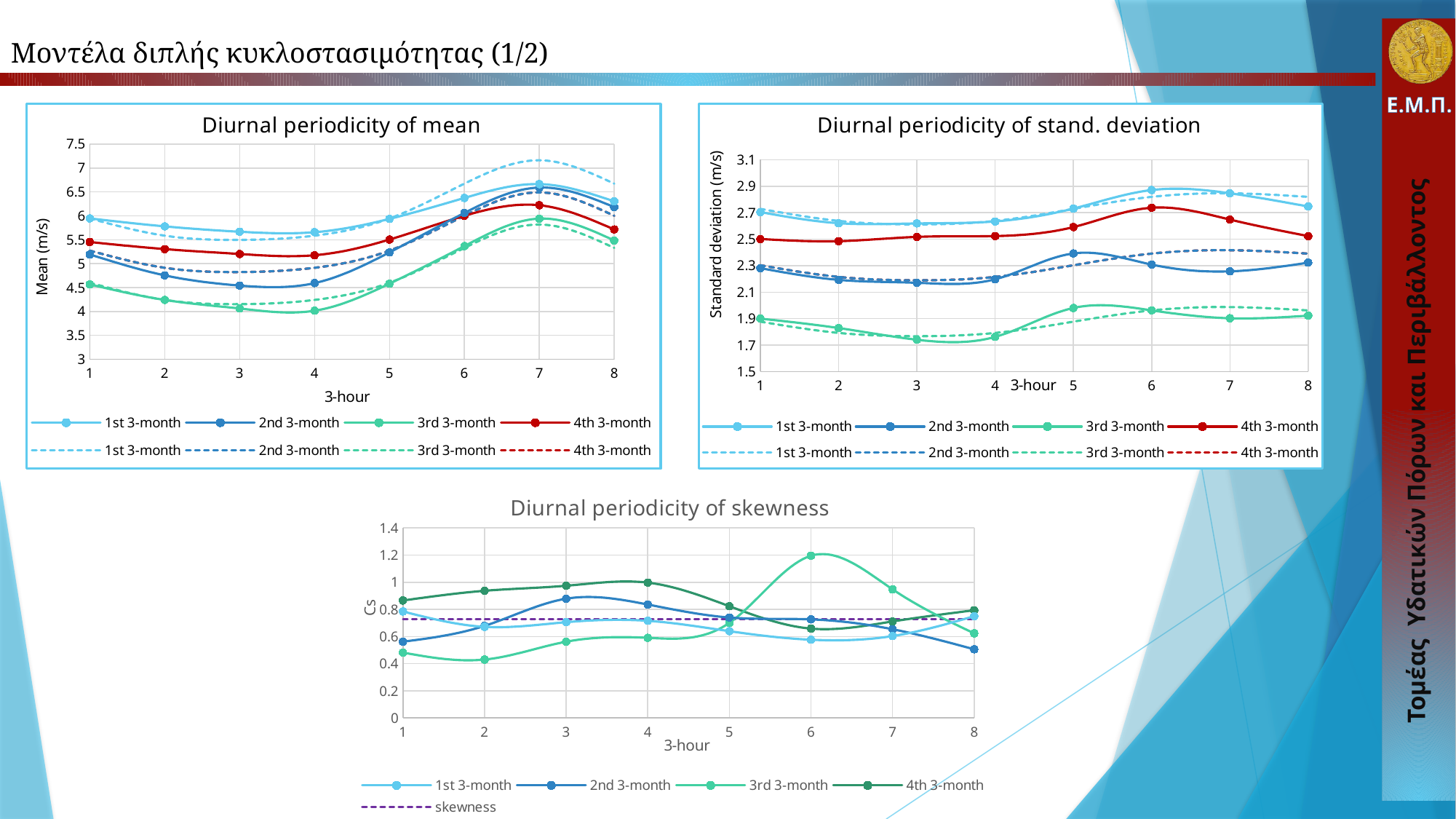
How many series does the legend of the "Diurnal periodicity of mean" chart list? 8 In the "Diurnal periodicity of stand. deviation" chart, which series has the lowest values across the whole x axis? 3rd 3-month In the "Diurnal periodicity of mean" chart, how many 3-hour points are plotted along the x axis? 8 How many charts are shown on the slide? 3 What type of chart is "Diurnal periodicity of mean"? Line chart In the "Diurnal periodicity of stand. deviation" chart, is the solid 3rd 3-month value at 3-hour 3 greater or less than 1.9? less In the "Diurnal periodicity of mean" chart, is the solid 1st 3-month value at 3-hour 1 greater or less than 5.5? greater In the "Diurnal periodicity of skewness" chart, is the 3rd 3-month value at 3-hour 6 greater or less than 1? greater How many series does the legend of the "Diurnal periodicity of skewness" chart list? 5 In the "Diurnal periodicity of mean" chart, does the solid 3rd 3-month series rise or fall from 3-hour 4 to 3-hour 7? rise In the "Diurnal periodicity of skewness" chart, at 3-hour 1, which is larger: the 4th 3-month value or the 2nd 3-month value? 4th 3-month